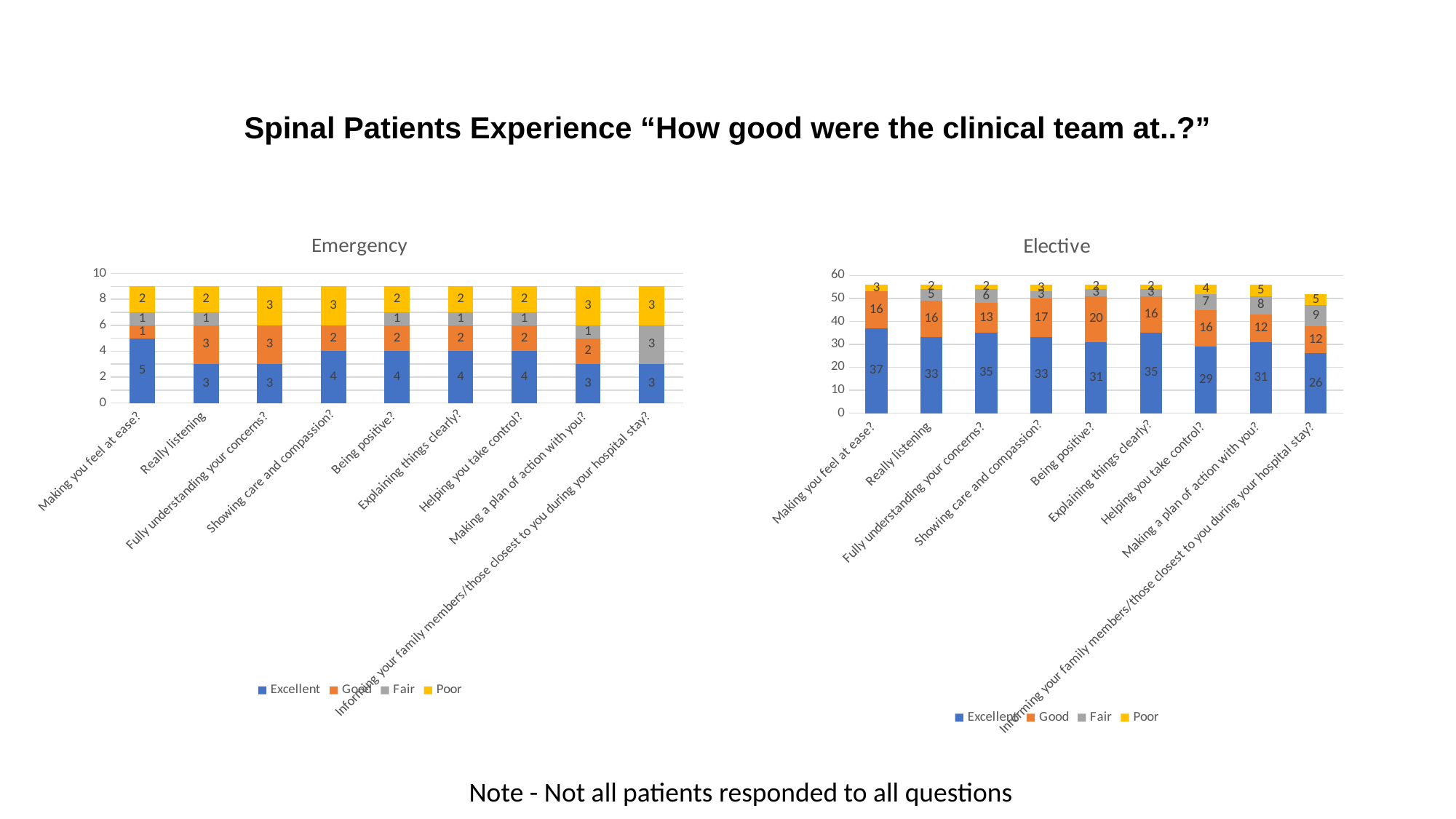
In the Emergency chart, which is larger: the Excellent value for "Showing care and compassion?" or for "Really listening"? Showing care and compassion? How many categories are shown on the x axis of the Emergency chart? 9 How many series does the legend of the Elective chart list? 4 In the Emergency chart, what is the Excellent value for "Making you feel at ease?"? 5 In the Elective chart, what is the difference between the Excellent values for "Making you feel at ease?" and "Helping you take control?"? 8 In the Elective chart, what is the total of the stacked bar for "Informing your family members/those closest to you during your hospital stay?"? 52 In the Elective chart, which category has the lowest Excellent value? Informing your family members/those closest to you during your hospital stay? In the Elective chart, which category has the highest Excellent value? Making you feel at ease? What kind of chart is the Elective chart? Stacked bar chart In the Elective chart, what is the Fair value for "Informing your family members/those closest to you during your hospital stay?"? 9 In the Elective chart, is the Excellent value for "Being positive?" greater or less than 40? less In the Elective chart, what is the Good value for "Being positive?"? 20